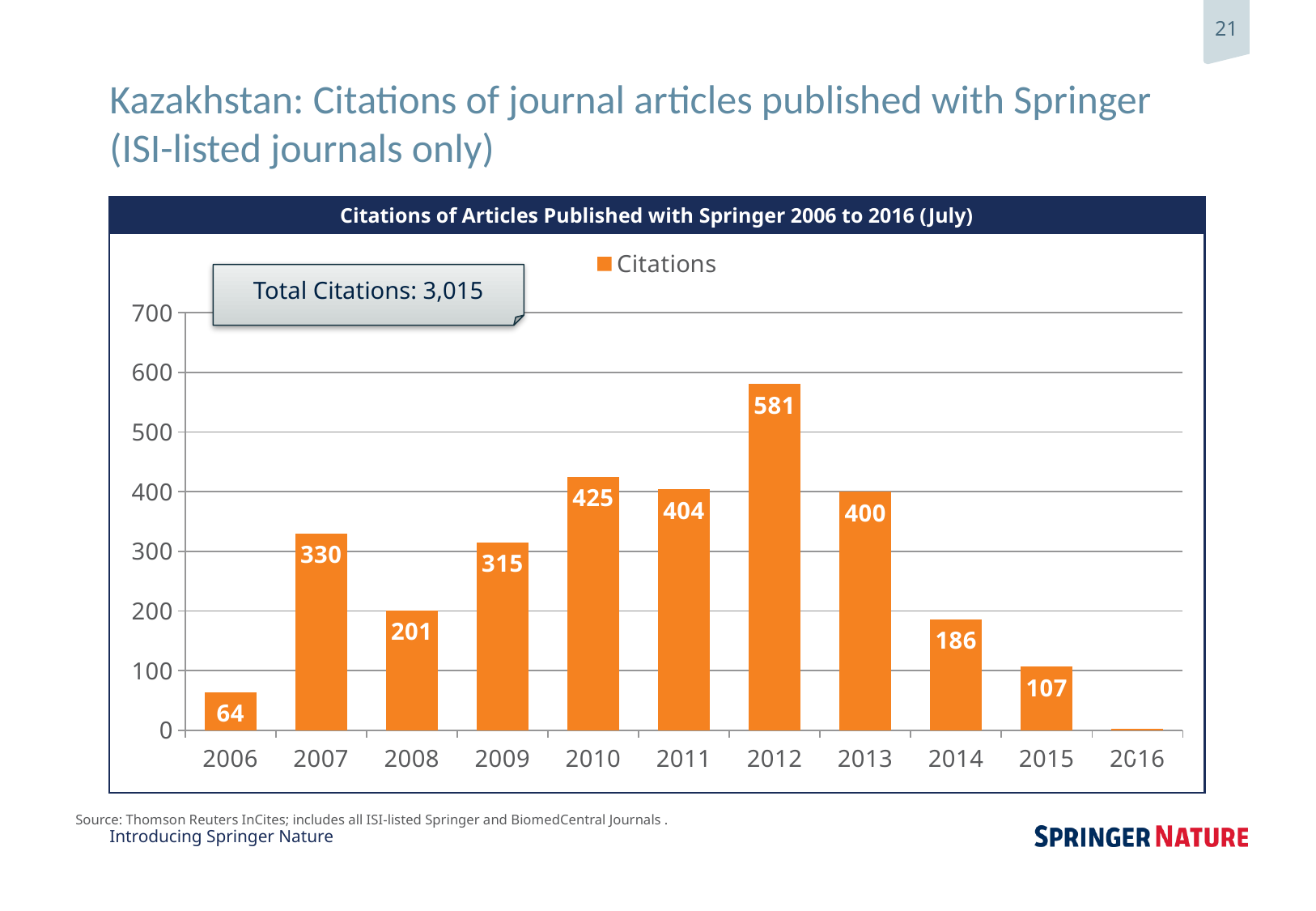
What is the difference in citations between 2012 and 2013? 181 How many citations were there in 2012? 581 Which year has the lowest number of citations? 2016 How many years are shown on the x axis? 11 Is the value for 2016 greater or less than 100? less What kind of chart is shown on the slide? Bar chart Do the citation values rise or fall from 2012 to 2015? Fall What total number of citations is shown in the callout box on the chart? 3,015 What is the citation count shown for 2006? 64 How many series does the legend list? 1 Which year has the highest number of citations? 2012 Which year had more citations, 2010 or 2011? 2010